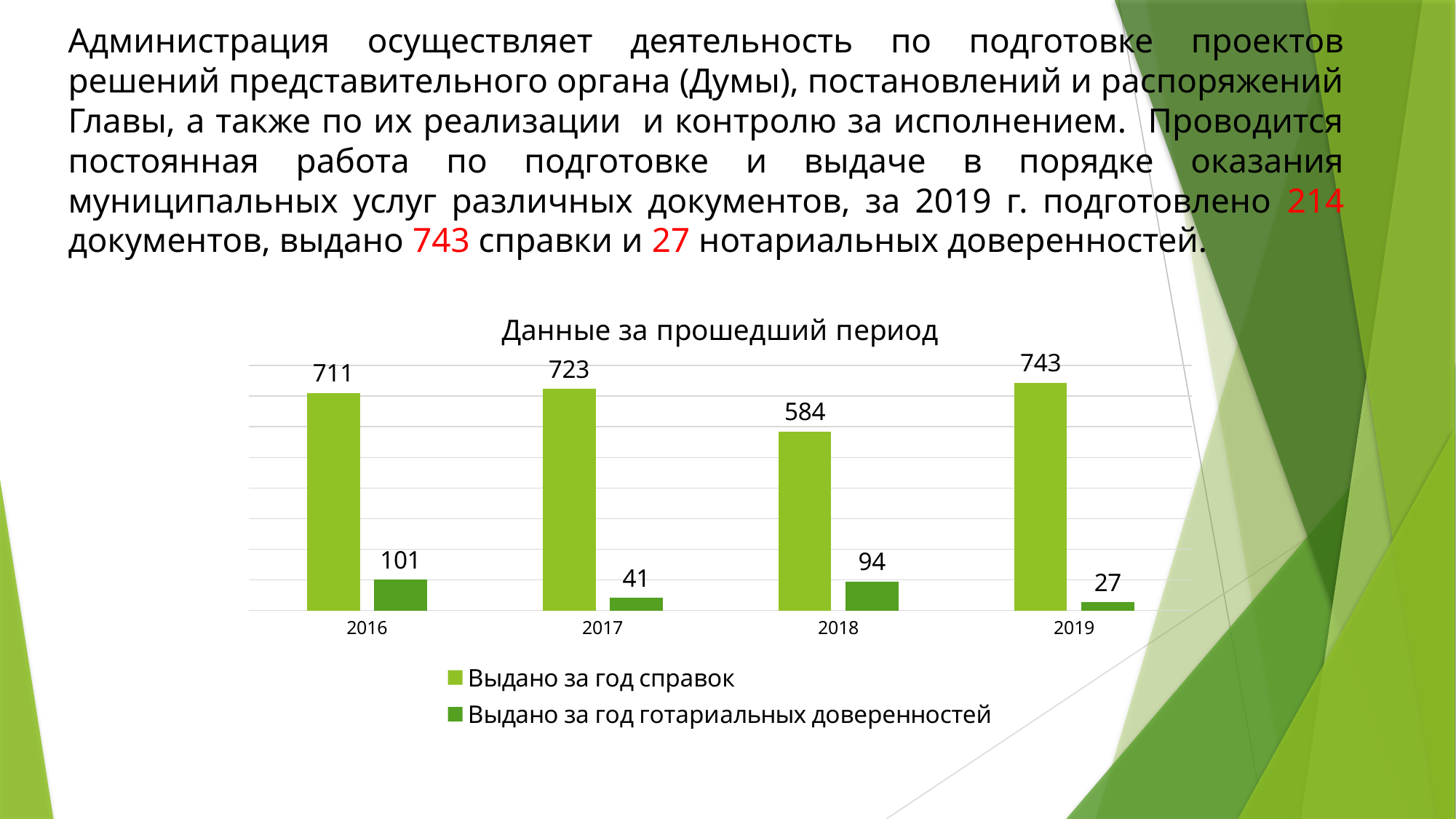
Which year has the highest value for 'Выдано за год справок'? 2019 How many years are shown on the x axis? 4 What is the value for 'Выдано за год справок' in 2016? 711 What is the value for 'Выдано за год справок' in 2019? 743 How many series does the legend list? 2 What kind of chart is shown on the slide? bar chart Which year has the lowest value for 'Выдано за год готариальных доверенностей'? 2019 What is the value for 'Выдано за год готариальных доверенностей' in 2018? 94 What is the difference between the 'Выдано за год справок' values for 2017 and 2018? 139 Which is larger: 'Выдано за год готариальных доверенностей' in 2016 or in 2017? 2016 Does the value for 'Выдано за год готариальных доверенностей' rise or fall from 2018 to 2019? fall What is the title of the chart? Данные за прошедший период